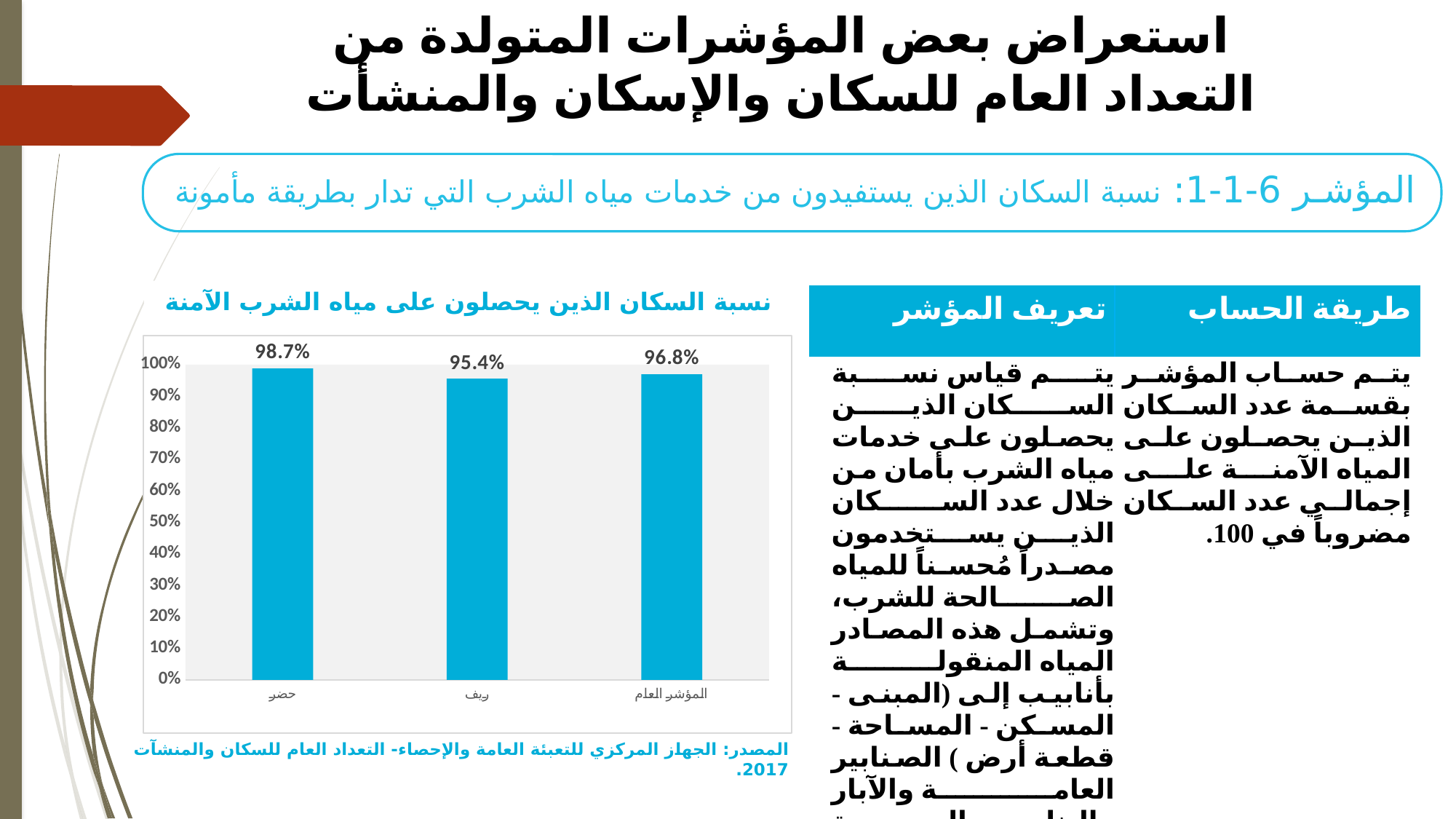
Which is larger, the value for ريف or the value for المؤشر العام? المؤشر العام What is the difference between the values for حضر and ريف? 3.3% What is the highest tick value shown on the vertical axis of the chart? 100% What kind of chart is shown on the slide? Bar chart Which category has the lowest value in the chart? ريف What is the title of the chart? نسبة السكان الذين يحصلون على مياه الشرب الآمنة What is the value for ريف (rural) in the chart? 95.4% How many categories are shown in the chart? 3 What is the value for المؤشر العام (overall indicator) in the chart? 96.8% Which category has the highest value in the chart? حضر What is the value for حضر (urban) in the chart? 98.7% What is the difference between the values for حضر and المؤشر العام? 1.9%